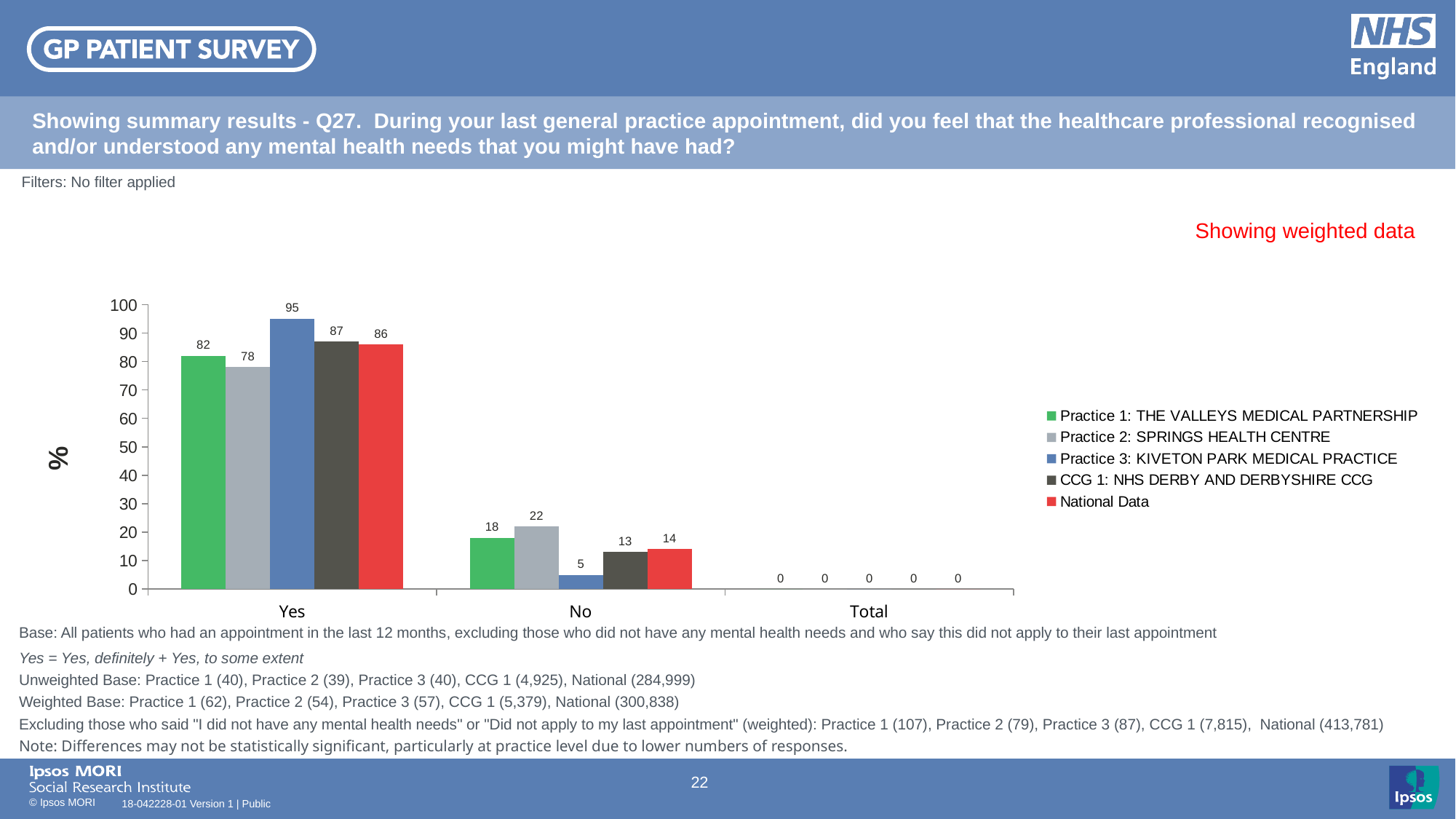
How many categories are shown on the x axis? 3 What is the value for National Data in the No category? 14 What colour represents National Data in the chart? red What is the difference between the Yes values for CCG 1: NHS DERBY AND DERBYSHIRE CCG and Practice 1: THE VALLEYS MEDICAL PARTNERSHIP? 5 Which series has the lowest value in the No category? Practice 3: KIVETON PARK MEDICAL PRACTICE What is the value for Practice 2: SPRINGS HEALTH CENTRE in the Yes category? 78 How many series does the legend list? 5 Which series has the highest value in the Yes category? Practice 3: KIVETON PARK MEDICAL PRACTICE What kind of chart is shown on the slide? bar chart In the No category, which is larger: Practice 1: THE VALLEYS MEDICAL PARTNERSHIP or Practice 2: SPRINGS HEALTH CENTRE? Practice 2: SPRINGS HEALTH CENTRE What is the value for Practice 3: KIVETON PARK MEDICAL PRACTICE in the Yes category? 95 Is the value for Practice 1: THE VALLEYS MEDICAL PARTNERSHIP in the Yes category greater or less than 80? greater